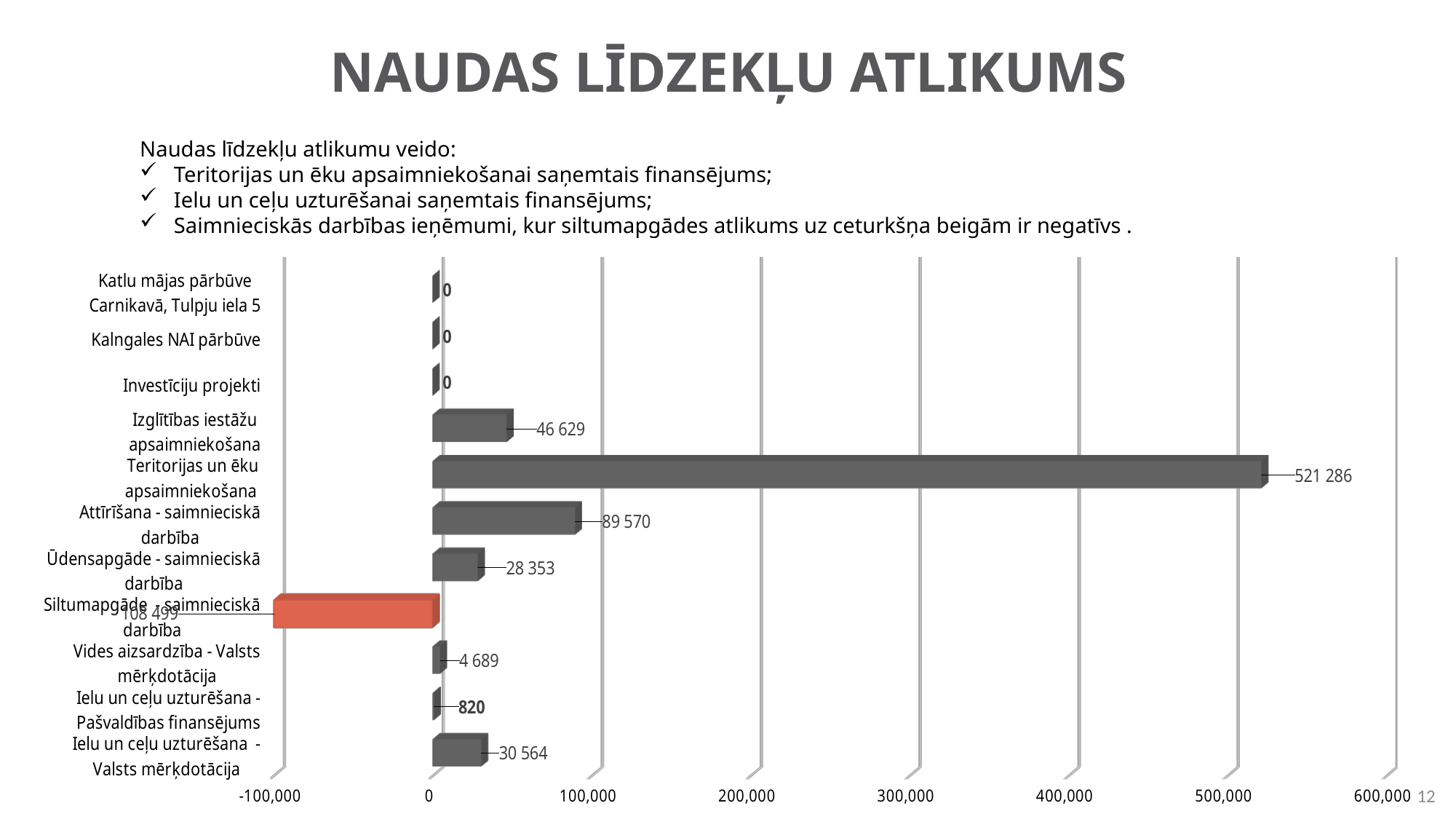
How many categories are shown in the chart? 11 What is the value for Attīrīšana - saimnieciskā darbība? 89 570 Which bar is shown in a different colour (red) from the others? Siltumapgāde - saimnieciskā darbība What kind of chart is shown on the slide? bar chart Which category has the highest value? Teritorijas un ēku apsaimniekošana What is the value for Ielu un ceļu uzturēšana - Pašvaldības finansējums? 820 Is the value for Siltumapgāde - saimnieciskā darbība greater or less than 0? less What is the difference between Attīrīšana - saimnieciskā darbība and Izglītības iestāžu apsaimniekošana? 42 941 Which is larger: Ūdensapgāde - saimnieciskā darbība or Ielu un ceļu uzturēšana - Valsts mērķdotācija? Ielu un ceļu uzturēšana - Valsts mērķdotācija What is the value for Vides aizsardzība - Valsts mērķdotācija? 4 689 What is the value for Teritorijas un ēku apsaimniekošana? 521 286 Which category has the lowest value? Siltumapgāde - saimnieciskā darbība